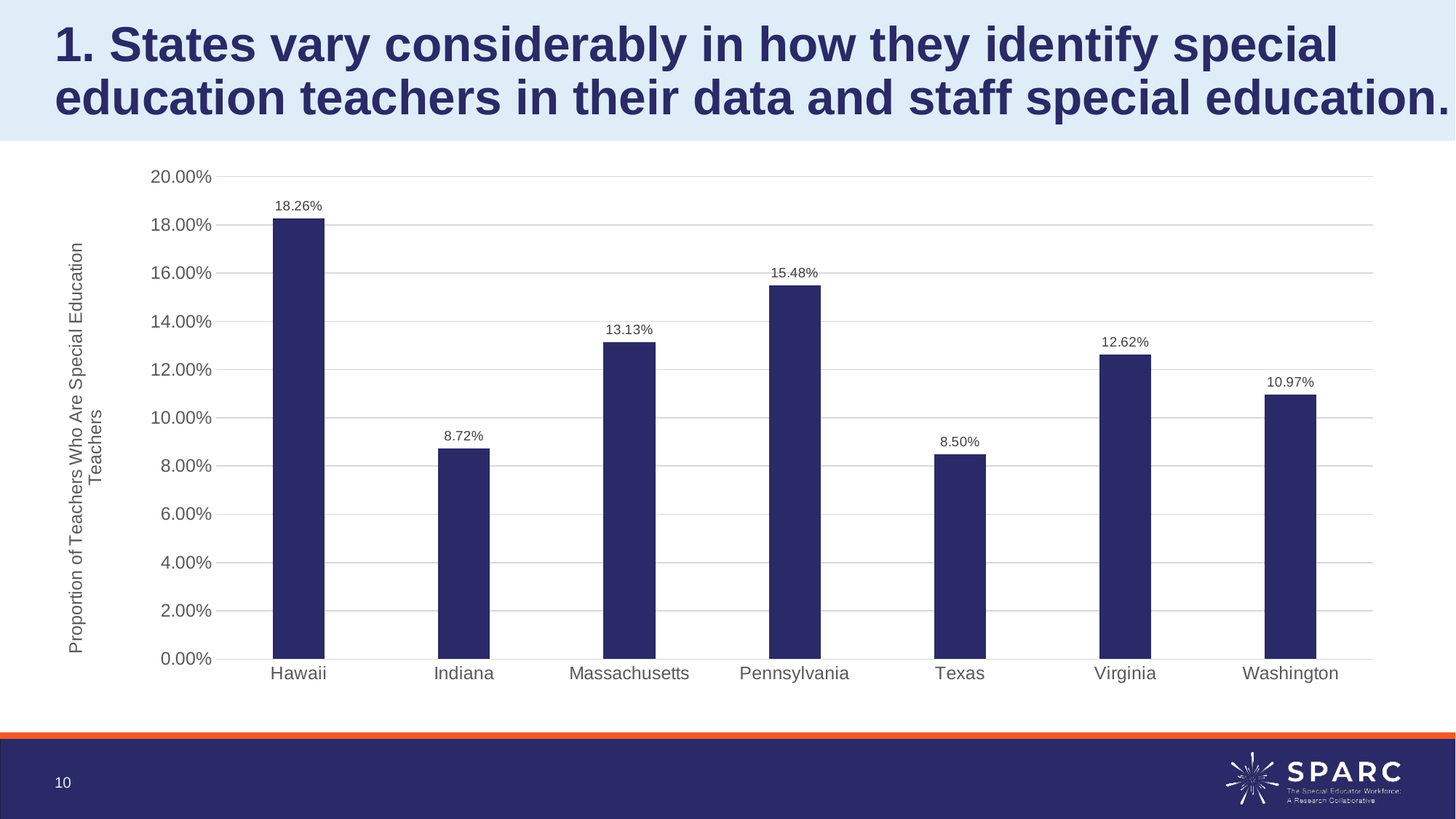
What kind of chart is shown on the slide? Bar chart Is the value for Virginia greater or less than 12.00%? greater What is the difference between the values for Massachusetts and Virginia? 0.51% Which state has the lowest proportion of special education teachers? Texas What is the label of the vertical axis? Proportion of Teachers Who Are Special Education Teachers Which has a larger value, Indiana or Washington? Washington Which state has the highest proportion of special education teachers? Hawaii How many states are shown on the x axis? 7 What is the value shown for Pennsylvania? 15.48% What is the proportion of teachers who are special education teachers in Hawaii? 18.26% What is the difference between the values for Hawaii and Texas? 9.76% What is the value shown for Washington? 10.97%